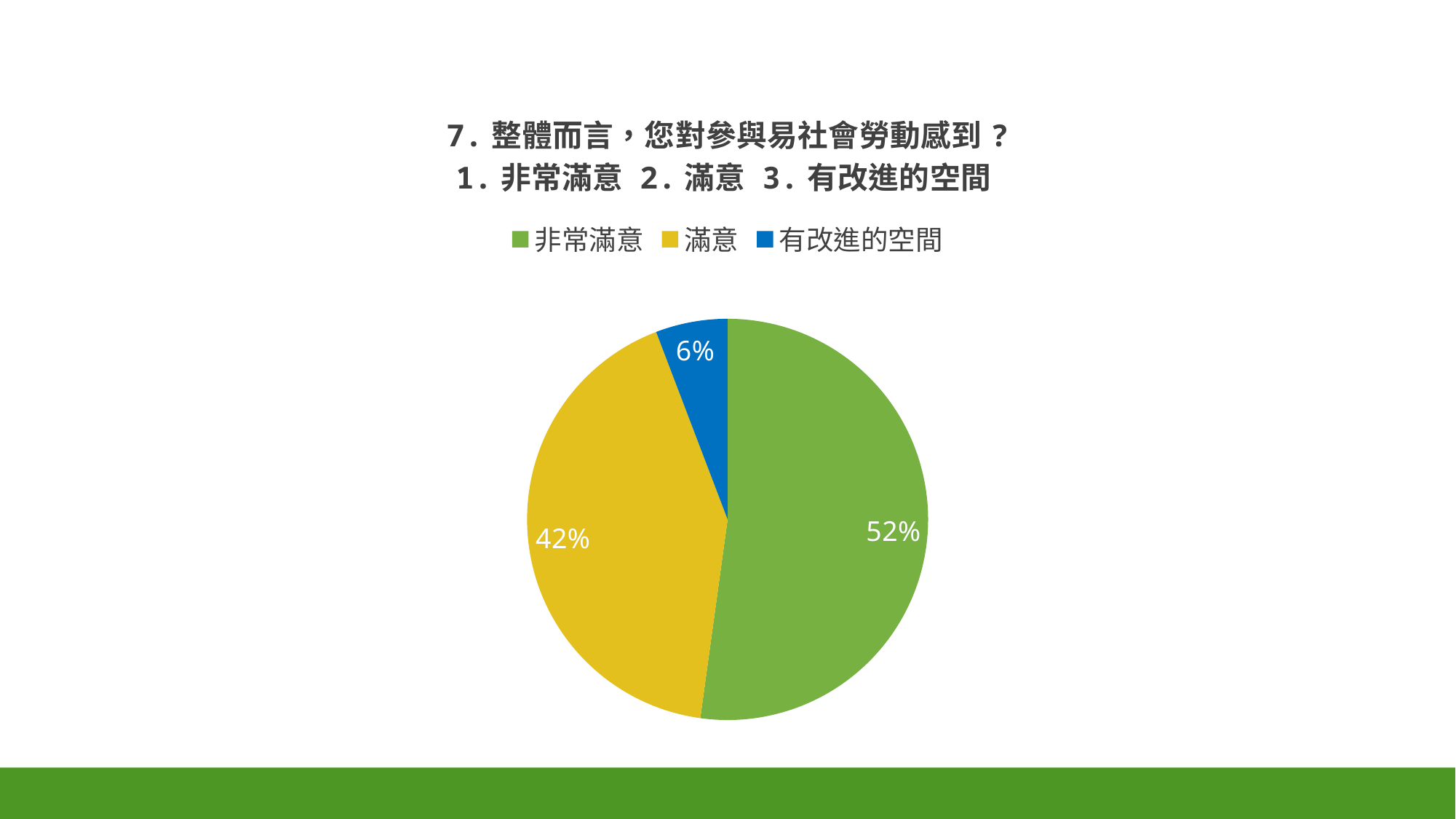
What colour is the slice for 有改進的空間? blue Which is larger, the slice for 滿意 or the slice for 有改進的空間? 滿意 Which category has the smallest slice of the pie? 有改進的空間 What share of the pie does 非常滿意 have? 52% What kind of chart is shown on the slide? pie chart What share of the pie does 滿意 have? 42% Which legend entry is shown in yellow? 滿意 What is the difference in percentage points between 滿意 and 有改進的空間? 36 Which category has the largest slice of the pie? 非常滿意 What share of the pie does 有改進的空間 have? 6% What is the difference in percentage points between 非常滿意 and 滿意? 10 How many categories does the pie chart show? 3